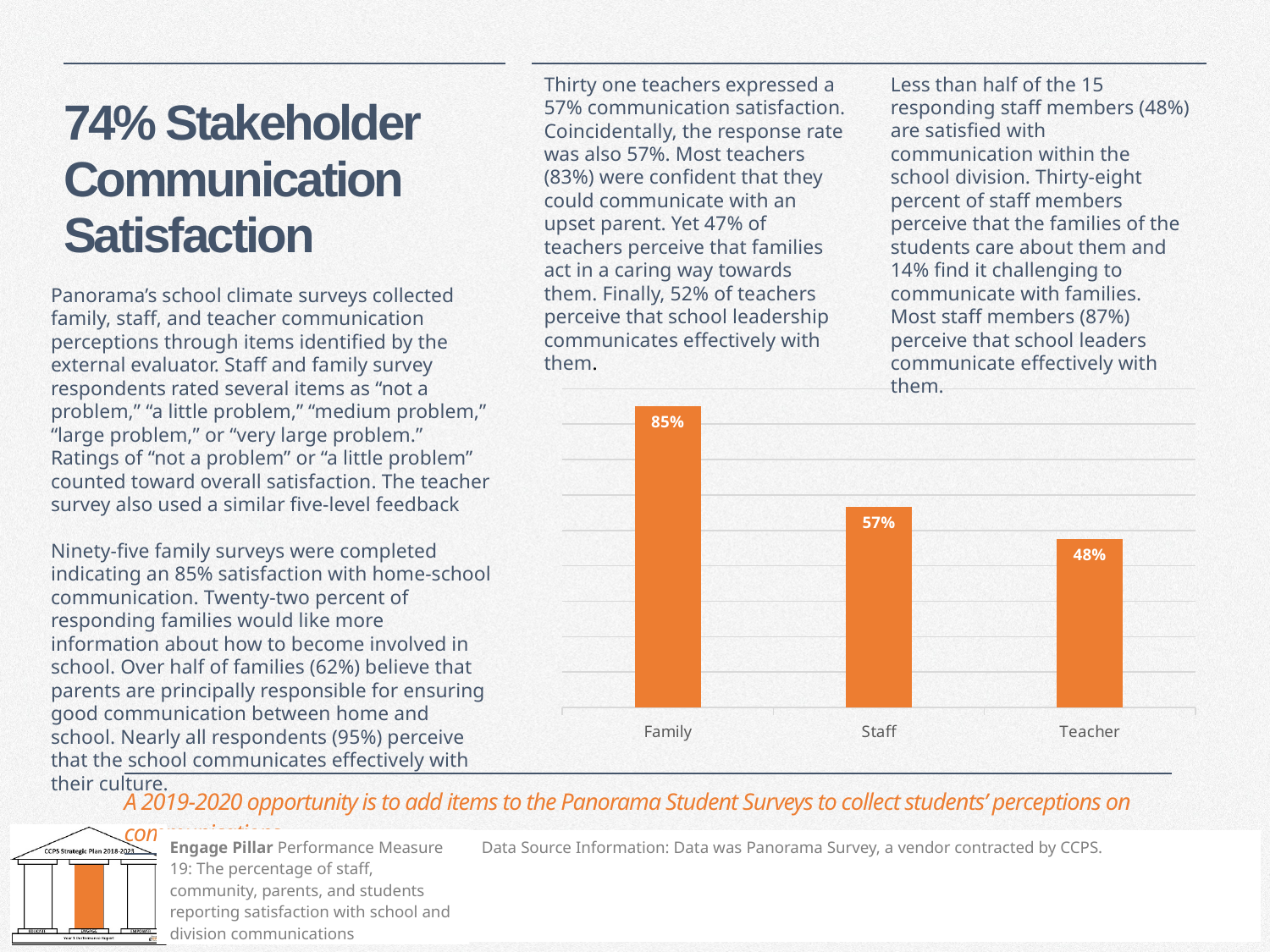
Do the values rise or fall from Family to Teacher along the x axis? Fall Which category has the highest communication satisfaction? Family What is the difference between the Family and Teacher values? 37% Which category has the lowest communication satisfaction? Teacher What kind of chart is shown on the slide? Bar chart Which is larger, the value for Staff or the value for Teacher? Staff What is the difference between the Staff and Teacher values? 9% What colour are the bars in the chart? Orange What is the communication satisfaction value for Family? 85% What is the communication satisfaction value for Teacher? 48% What is the communication satisfaction value for Staff? 57% How many categories are shown on the chart? 3